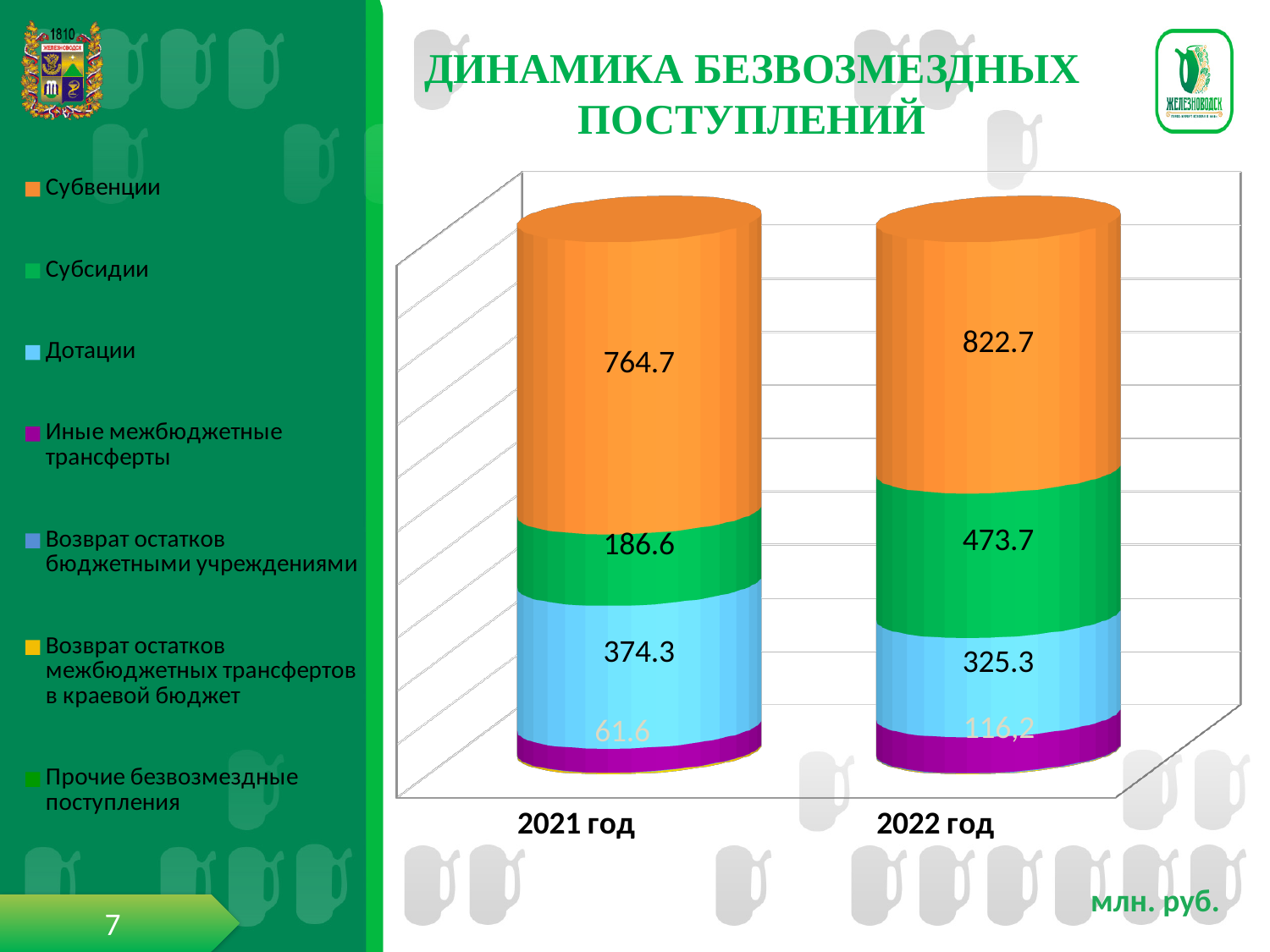
How many series does the legend list? 7 What kind of chart is shown on the slide? Stacked bar chart Which series has the largest value in 2022 год? Субвенции What is the difference between Субсидии in 2022 год and in 2021 год? 287.1 What is the value for Субвенции in 2021 год? 764.7 What is the value for Дотации in 2021 год? 374.3 Do the values for Субсидии rise or fall from 2021 год to 2022 год? Rise By how much did Субвенции increase from 2021 год to 2022 год? 58.0 What is the value for Иные межбюджетные трансферты in 2022 год? 116,2 How many years (categories) are shown on the x axis? 2 Which year has the larger value for Дотации, 2021 год or 2022 год? 2021 год What is the value for Субсидии in 2022 год? 473.7